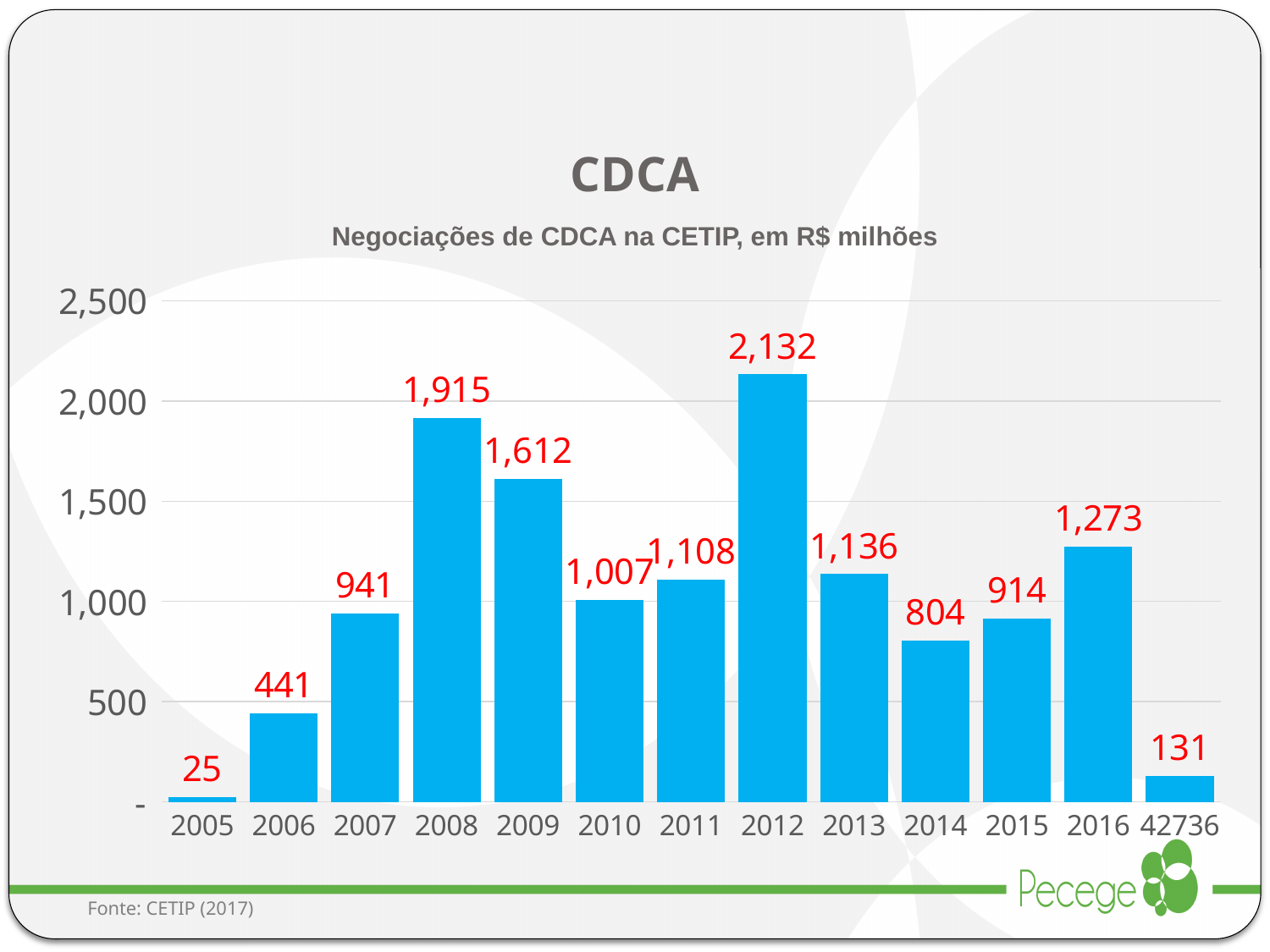
Which year has the highest value? 2012 What is the value for 2016? 1,273 What is the value for 2005? 25 How many bars are shown in the chart? 13 Do the values rise or fall from 2005 to 2008? rise Which is larger, the value for 2013 or the value for 2011? 2013 What kind of chart is shown on the slide? bar chart What is the value for 2012? 2,132 What is the difference between the values for 2008 and 2009? 303 Is the value for 2014 greater or less than 1,000? less What is the subtitle of the chart? Negociações de CDCA na CETIP, em R$ milhões Which category has the lowest value? 2005